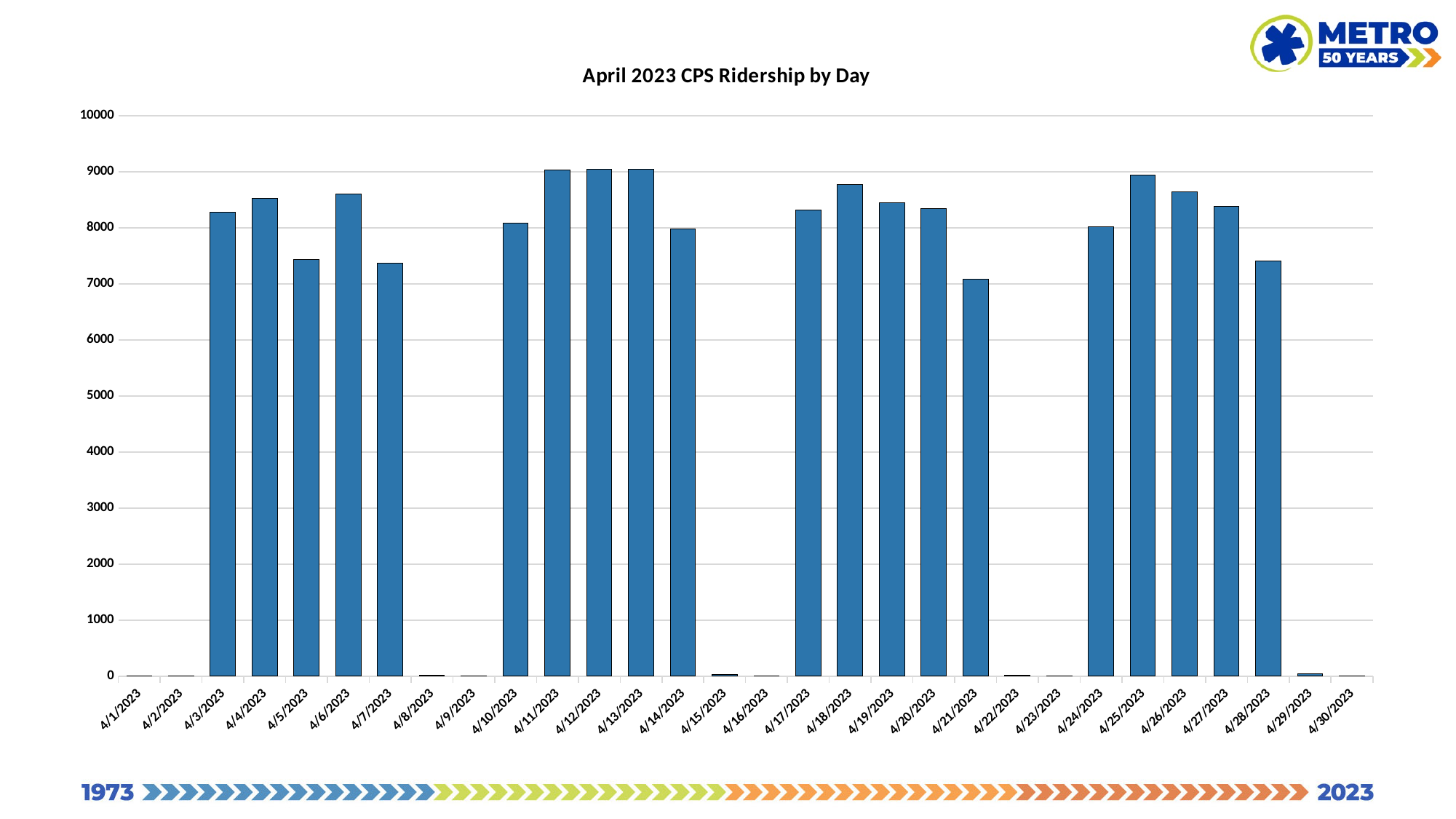
Which day has the higher ridership, 4/18/2023 or 4/21/2023? 4/18/2023 Is the value for 4/3/2023 greater or less than 8000? greater What kind of chart is shown on the slide? bar chart Is the value for 4/28/2023 greater or less than 7000? greater Which day has the higher ridership, 4/5/2023 or 4/6/2023? 4/6/2023 What is the title of the chart? April 2023 CPS Ridership by Day From 4/18/2023 to 4/21/2023, do the ridership values rise or fall? fall Is the value for 4/5/2023 greater or less than 8000? less How many days (categories) are shown on the x axis of the chart? 30 Which day has the higher ridership, 4/24/2023 or 4/25/2023? 4/25/2023